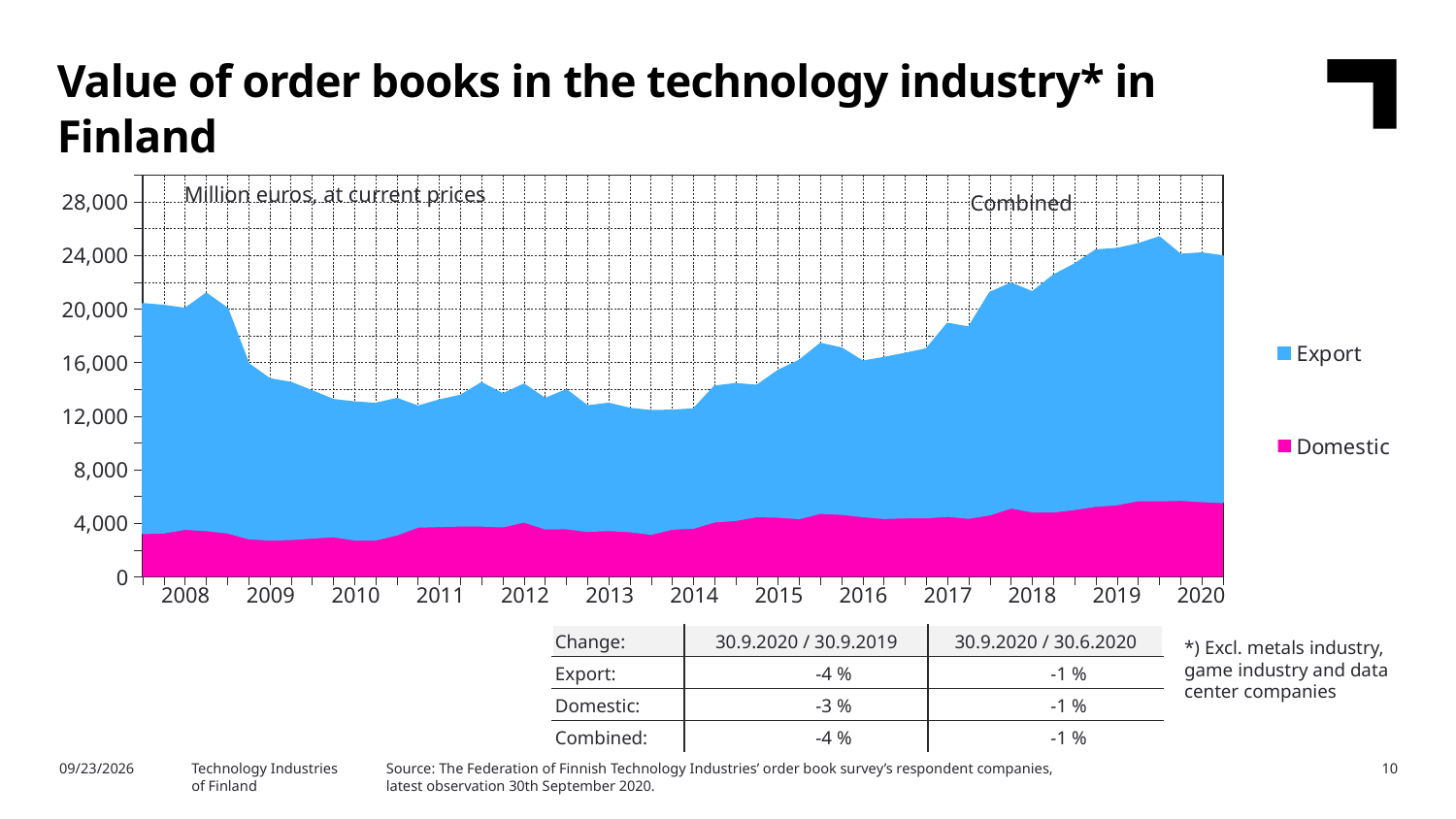
Is the Domestic value in 2020 greater or less than 4,000? greater In which year does the combined value reach its highest point? 2019 What unit is stated at the top of the chart? Million euros, at current prices How many year labels are shown on the x axis? 13 Is the combined value at the start of 2008 greater or less than 16,000? greater What are the two series named in the legend? Export and Domestic Does the combined value rise or fall from 2017 to 2019? rise What kind of chart is shown on the slide? Area chart Is the combined value in 2013 greater or less than 16,000? less How many series does the legend list? 2 Which series is larger in 2020, Export or Domestic? Export